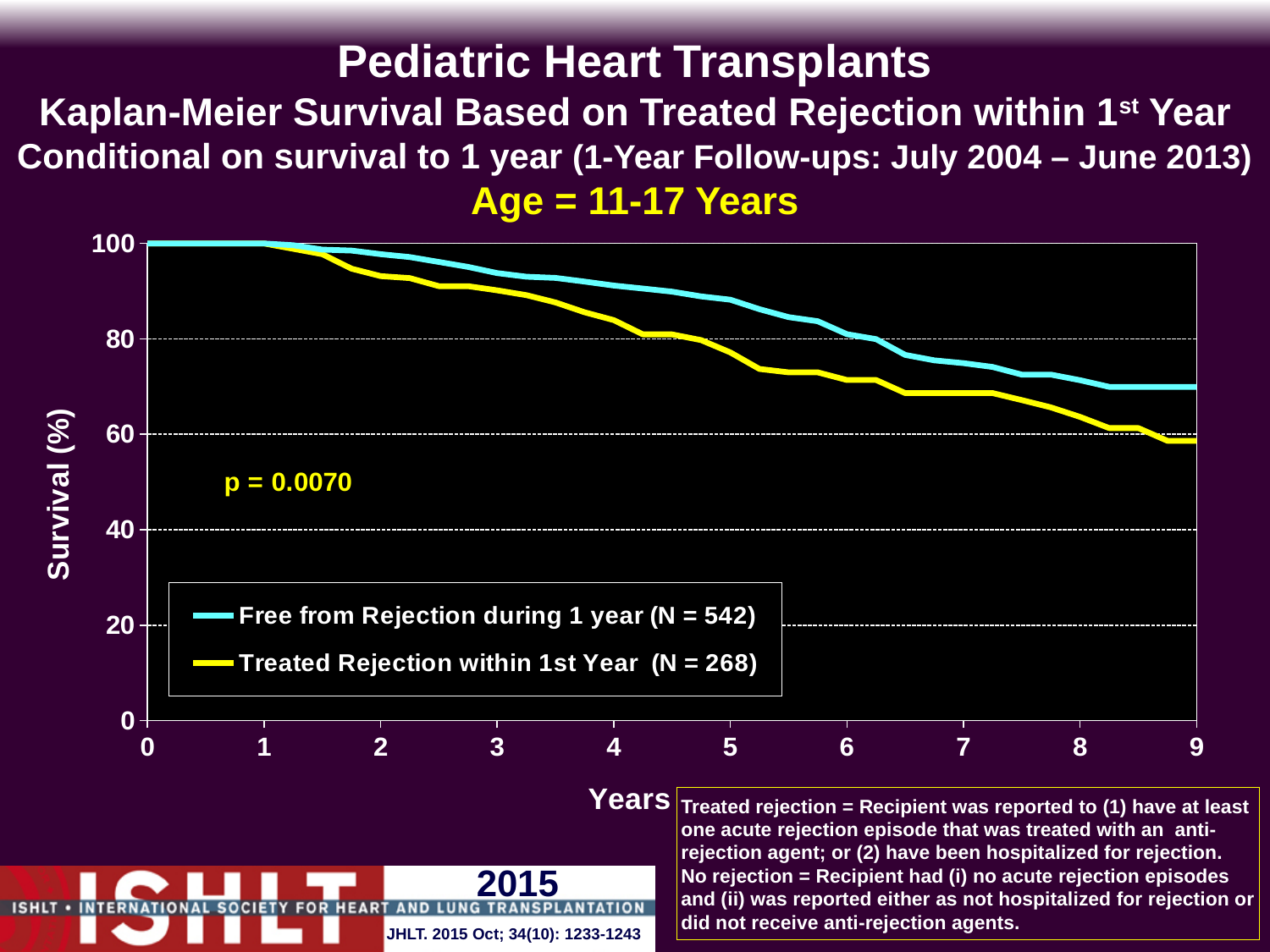
Is the survival for the Treated Rejection within 1st Year group at year 4 greater or less than 80? greater At year 5, which group has higher survival: Free from Rejection during 1 year or Treated Rejection within 1st Year? Free from Rejection during 1 year What is the highest value shown on the x axis (Years)? 9 What kind of chart is shown on the slide? line chart What is the N for the 'Treated Rejection within 1st Year' group shown in the legend? 268 Is the survival for the Free from Rejection during 1 year group at year 9 greater or less than 60? greater Is the survival for the Free from Rejection during 1 year group at year 7 greater or less than 80? less What is the survival (%) for both groups at year 0? 100 How many series does the legend list? 2 Do the survival curves rise or fall as years increase? fall What is the N for the 'Free from Rejection during 1 year' group shown in the legend? 542